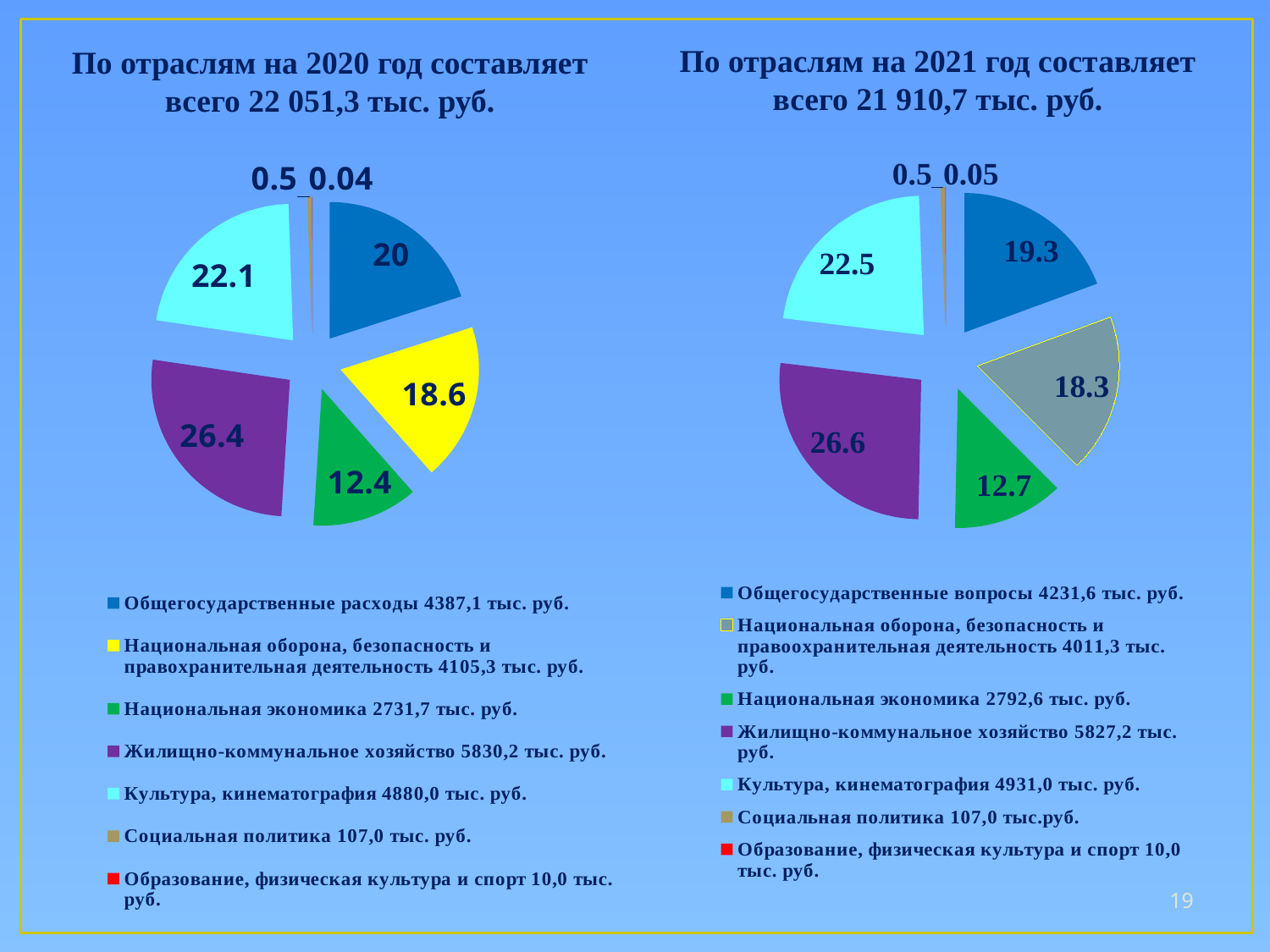
What total amount is stated in the title of the 2020 chart (left)? 22 051,3 тыс. руб. In the 2020 chart (left), what is the difference between the labels for Жилищно-коммунальное хозяйство (26.4) and Национальная экономика (12.4)? 14 In the 2021 chart (right), what is the data label on the slice for Национальная экономика? 12.7 In the 2020 chart (left), which category has the largest slice? Жилищно-коммунальное хозяйство According to the legend of the 2021 chart (right), what amount is given for Жилищно-коммунальное хозяйство? 5827,2 тыс. руб. In the 2020 chart (left), what is the data label on the slice for Социальная политика? 0.5 In the 2021 chart (right), which slice is larger: Общегосударственные вопросы or Национальная оборона, безопасность и правоохранительная деятельность? Общегосударственные вопросы How many categories does the legend of the 2020 chart (left) list? 7 In the 2020 chart (left), what is the data label on the slice for Жилищно-коммунальное хозяйство? 26.4 In the 2021 chart (right), what is the data label on the slice for Культура, кинематография? 22.5 In the 2021 chart (right), which category has the smallest slice? Образование, физическая культура и спорт What type of chart is used on the left side of the slide for 2020? Pie chart